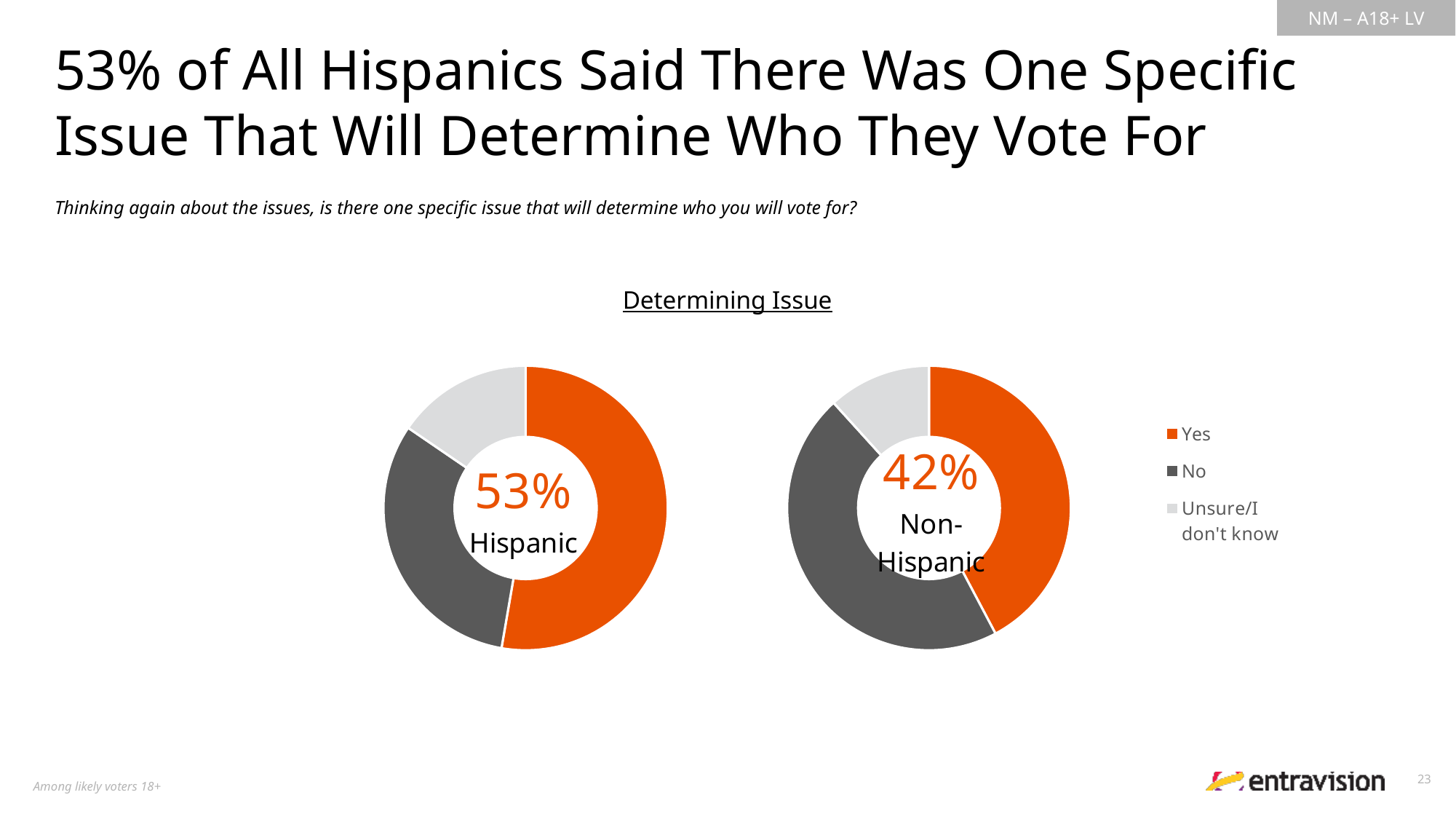
In the Hispanic donut chart, which response has the smallest slice? Unsure/I don't know In the Non-Hispanic donut chart, what percentage answered Yes? 42% In the Non-Hispanic donut chart, which response has the smallest slice? Unsure/I don't know In the Hispanic donut chart, what percentage answered Yes? 53% What is the title shown above the two donut charts? Determining Issue In the Hispanic donut chart, which response has the largest slice? Yes What kind of chart is used to show the Determining Issue results? Donut (pie) chart Which colour represents the No response in the donut charts? Dark grey Which group has the higher Yes share, Hispanic or Non-Hispanic? Hispanic How many slices does the Hispanic donut chart have? 3 What is the difference in percentage points between the Hispanic Yes share and the Non-Hispanic Yes share? 11 How many response categories does the legend list? 3